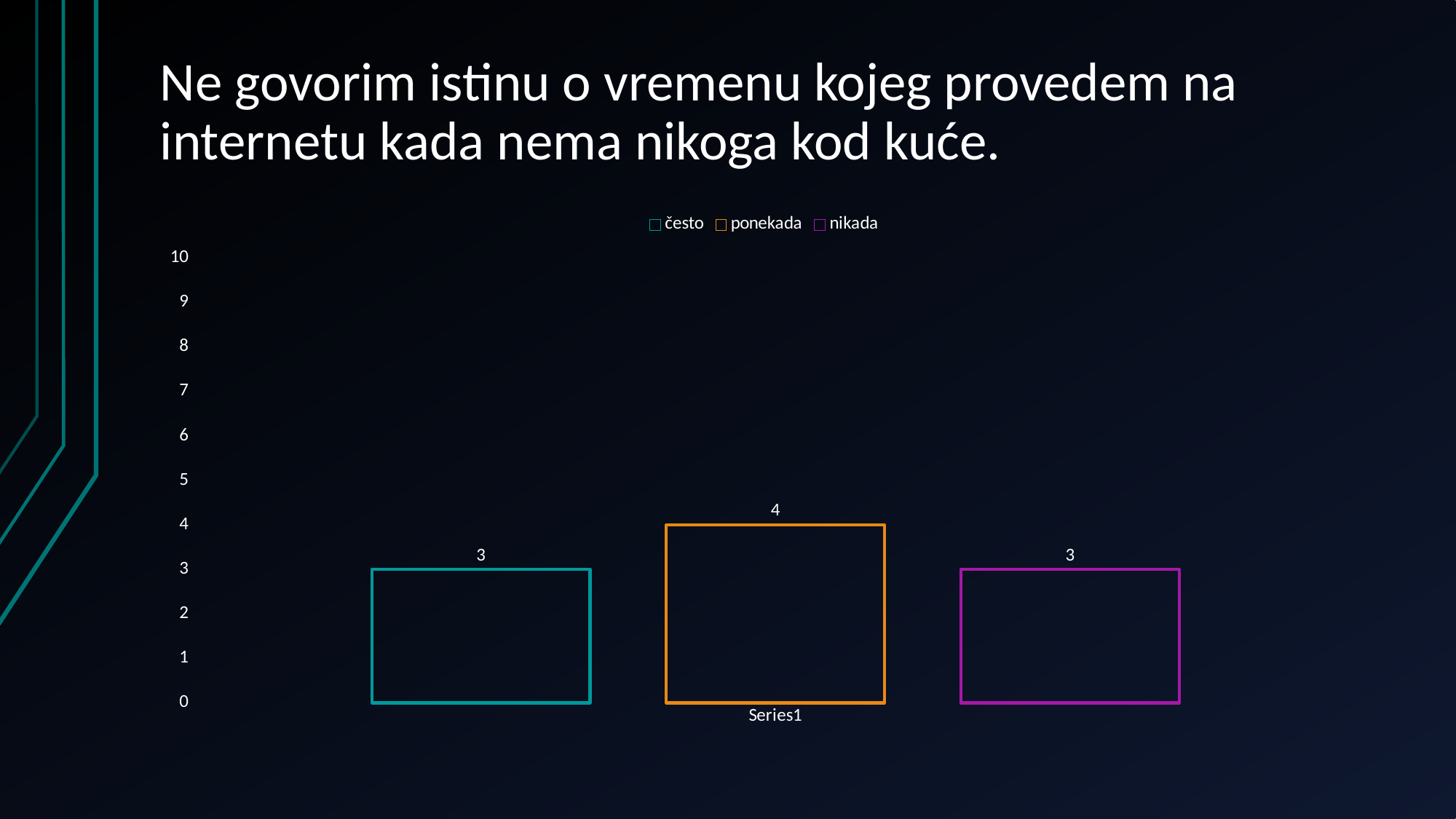
What is the value for "nikada"? 3 Is the value for "ponekada" greater or less than 5? less Which is larger, the value for "ponekada" or the value for "nikada"? ponekada What is the value for "često"? 3 What kind of chart is shown on the slide? bar chart Which series has the highest value? ponekada What is the total of the three plotted values? 10 What is the value for "ponekada"? 4 What is the difference between the values for "ponekada" and "često"? 1 What is the highest value shown on the vertical axis? 10 What is the label shown on the horizontal axis under the bars? Series1 How many series does the legend list? 3